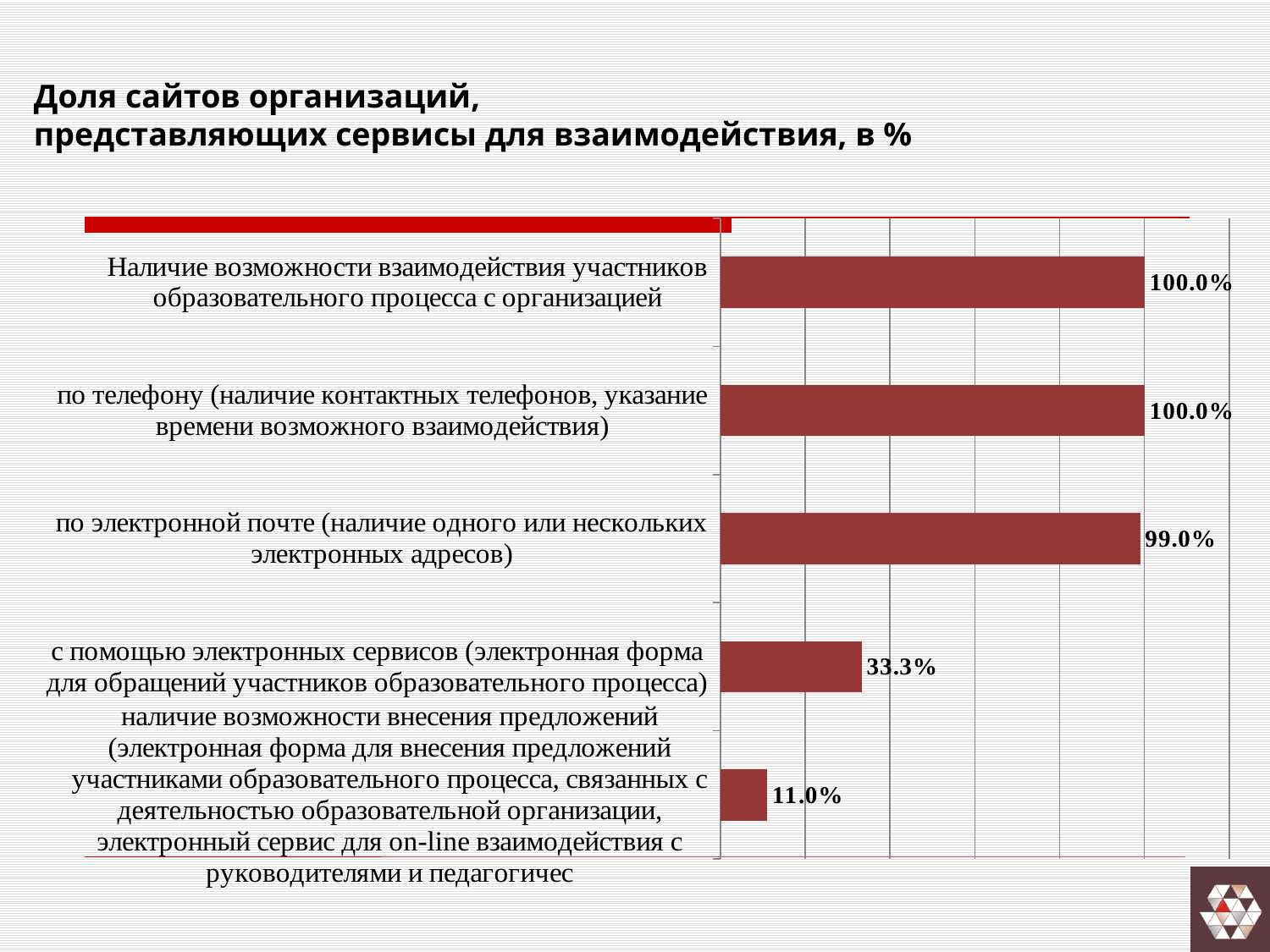
Which category has the lowest value? наличие возможности внесения предложений (электронная форма для внесения предложений участниками образовательного процесса...) How many categories have a value of 100.0%? 2 What is the value for "по электронной почте (наличие одного или нескольких электронных адресов)"? 99.0% What is the title of the chart on the slide? Доля сайтов организаций, представляющих сервисы для взаимодействия, в % What is the value for the category about "наличие возможности внесения предложений"? 11.0% What is the difference between the values for "по электронной почте" and "с помощью электронных сервисов"? 65.7% What is the value for "по телефону (наличие контактных телефонов, указание времени возможного взаимодействия)"? 100.0% How many categories (bars) does the chart show? 5 What type of chart is shown on the slide? bar chart What is the value for "с помощью электронных сервисов (электронная форма для обращений участников образовательного процесса)"? 33.3% Which is larger: the value for "по электронной почте" or the value for "с помощью электронных сервисов"? по электронной почте What is the difference between the values for "с помощью электронных сервисов" and "наличие возможности внесения предложений"? 22.3%